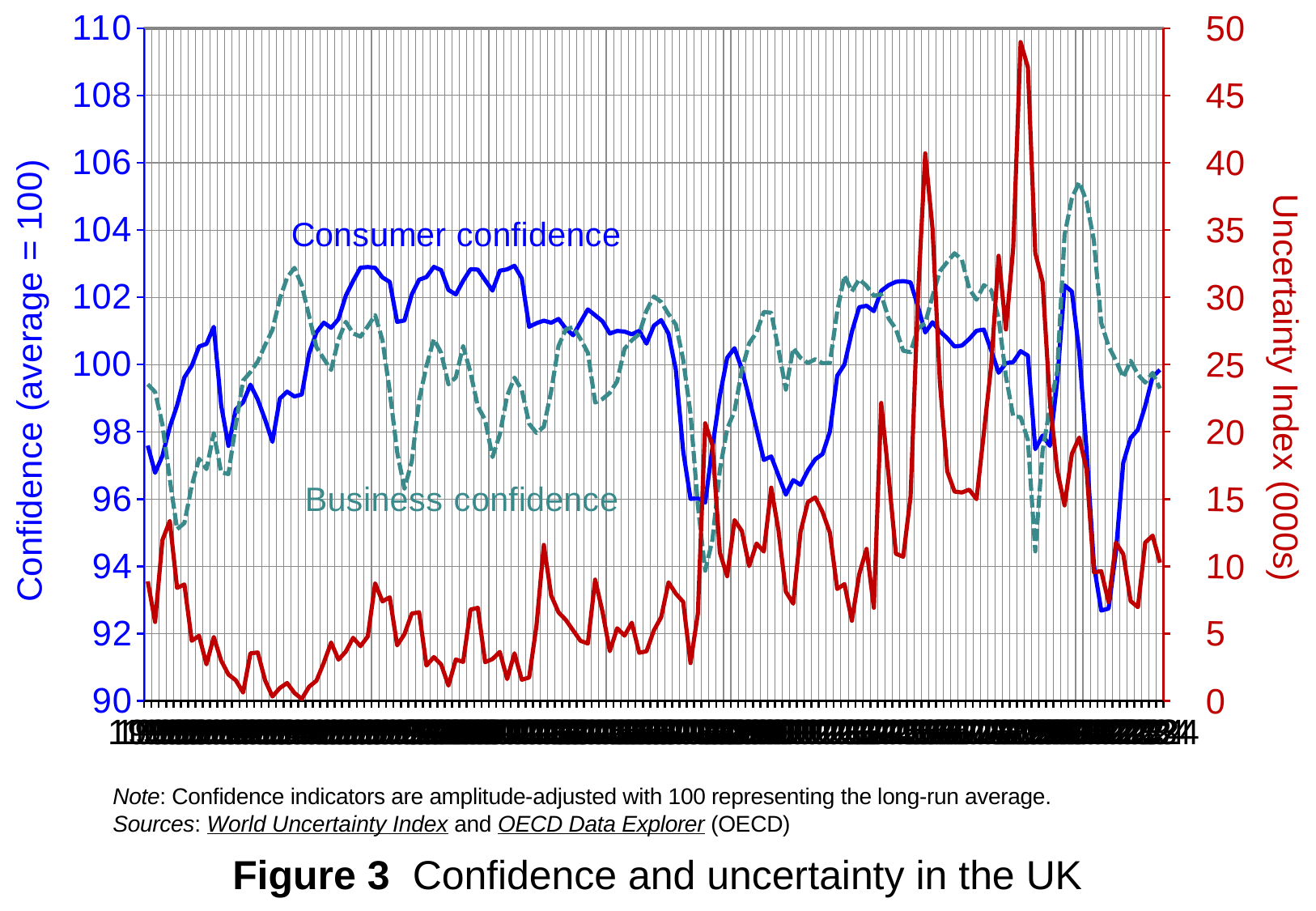
What is the title of the figure? Figure 3 Confidence and uncertainty in the UK Is the lowest value reached by Consumer confidence greater or less than 94? less How many data series are plotted on the chart? 3 Which series is drawn as a dashed line? Business confidence Which series reaches a higher peak, Consumer confidence or Business confidence? Business confidence Is the lowest value of the Uncertainty Index greater or less than 5? less Does the Uncertainty Index reach its highest value in the first half or the second half of the period shown? second half Is the highest value reached by the Uncertainty Index greater or less than 45? greater What kind of chart is shown on the slide? Line chart